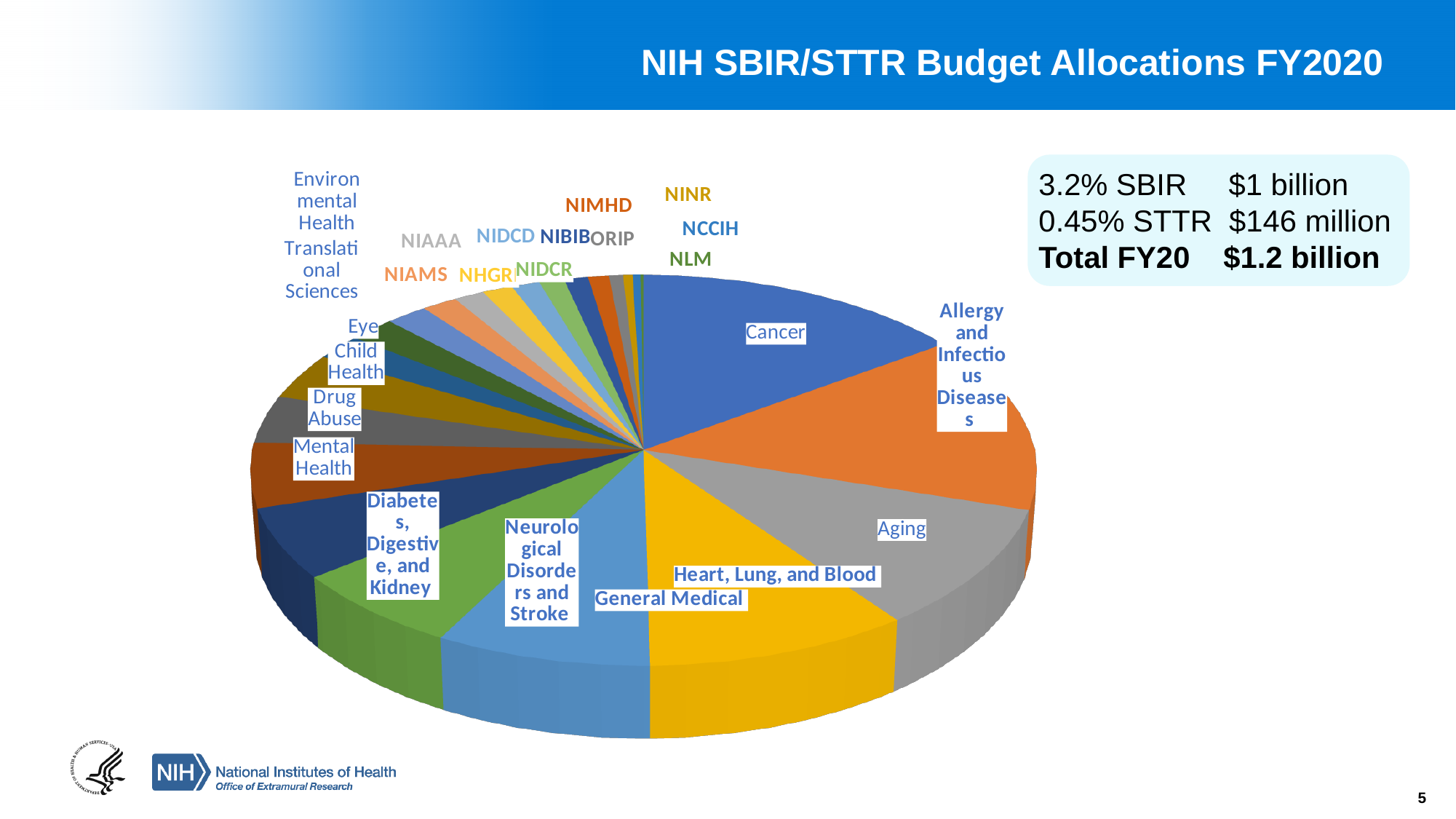
Which slice is larger, Cancer or Aging? Cancer Which slice is larger, Allergy and Infectious Diseases or Mental Health? Allergy and Infectious Diseases What is the title of the slide containing the pie chart? NIH SBIR/STTR Budget Allocations FY2020 What kind of chart is shown on the slide? pie chart What colour is the Cancer slice of the pie chart? blue Which slice is larger, Cancer or Allergy and Infectious Diseases? Cancer Which category has the largest slice of the pie? Cancer